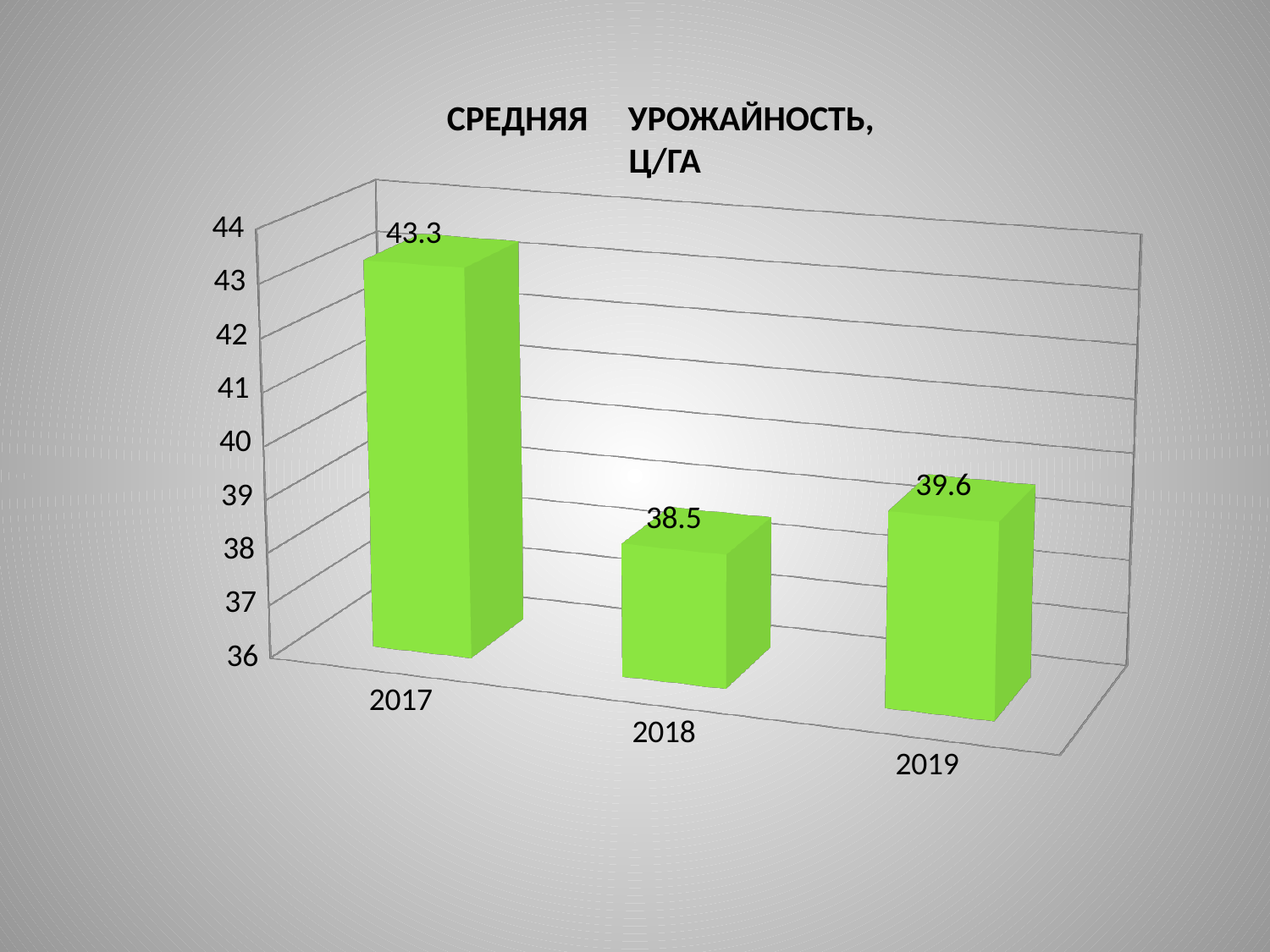
What is the average yield value shown for 2019? 39.6 Is the value for 2019 greater or less than 40? less How many years are shown on the chart? 3 Which year has the highest average yield? 2017 What kind of chart is shown on the slide? bar chart Which year has a larger average yield, 2018 or 2019? 2019 What is the difference between the average yield in 2017 and in 2018? 4.8 What is the title of the chart? СРЕДНЯЯ УРОЖАЙНОСТЬ, Ц/ГА What is the average yield value shown for 2018? 38.5 What is the average yield value shown for 2017? 43.3 Which year has the lowest average yield? 2018 What is the difference between the average yield in 2019 and in 2018? 1.1